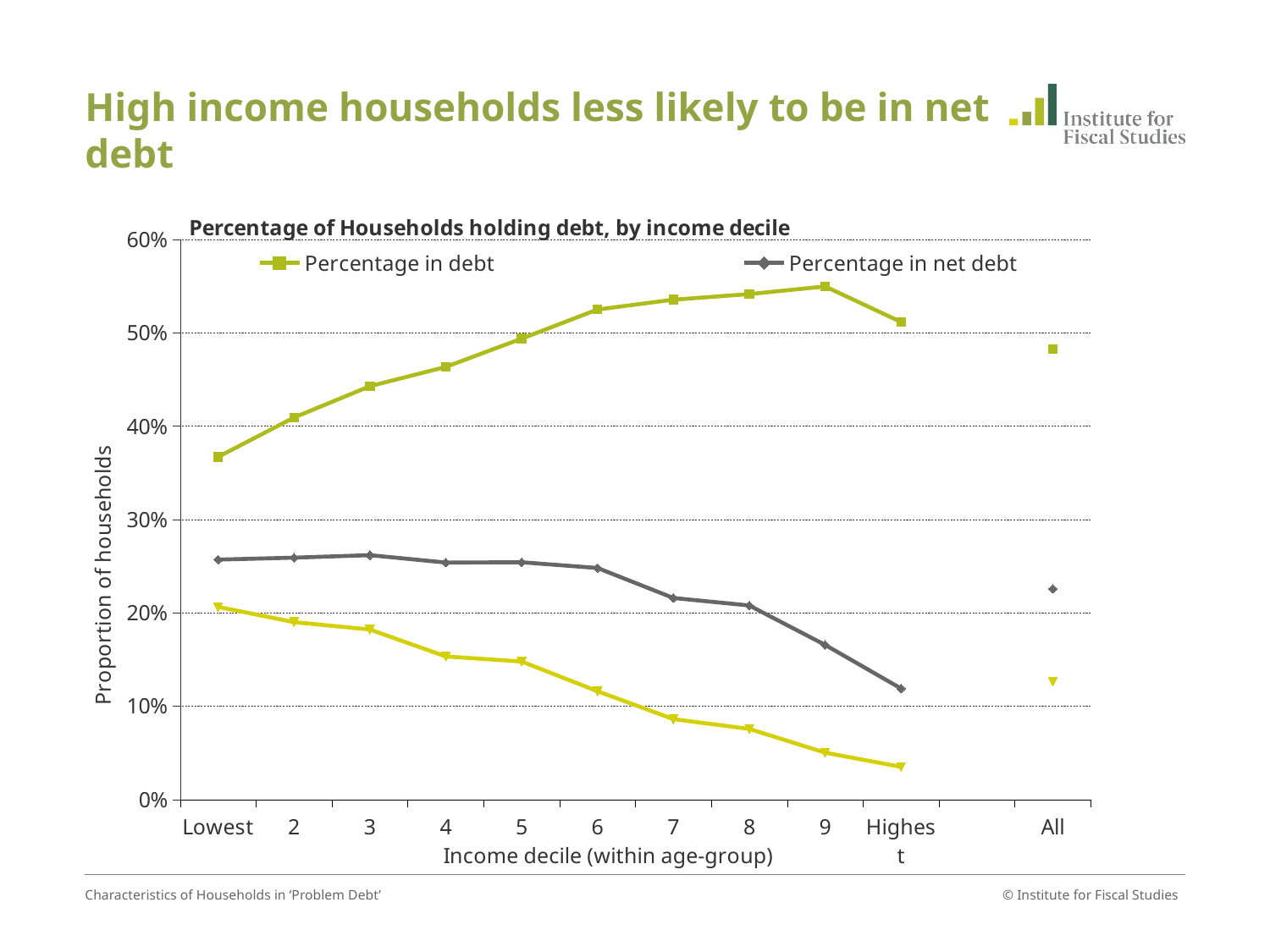
Is the value of Percentage in net debt for the Lowest income decile greater or less than 20%? greater Which income decile has the lowest value for Percentage in net debt? Highest Is the value of Percentage in debt for the Lowest income decile greater or less than 30%? greater How many categories are shown on the x axis? 11 Is the value of Percentage in debt for the All category greater or less than 50%? less How many series does the legend list? 2 Does Percentage in net debt rise or fall from the Lowest to the Highest income decile? Fall What is the title of the chart? Percentage of Households holding debt, by income decile What kind of chart is shown on the slide? Line chart What is the label on the y axis? Proportion of households Which income decile has the lowest value for Percentage in debt? Lowest